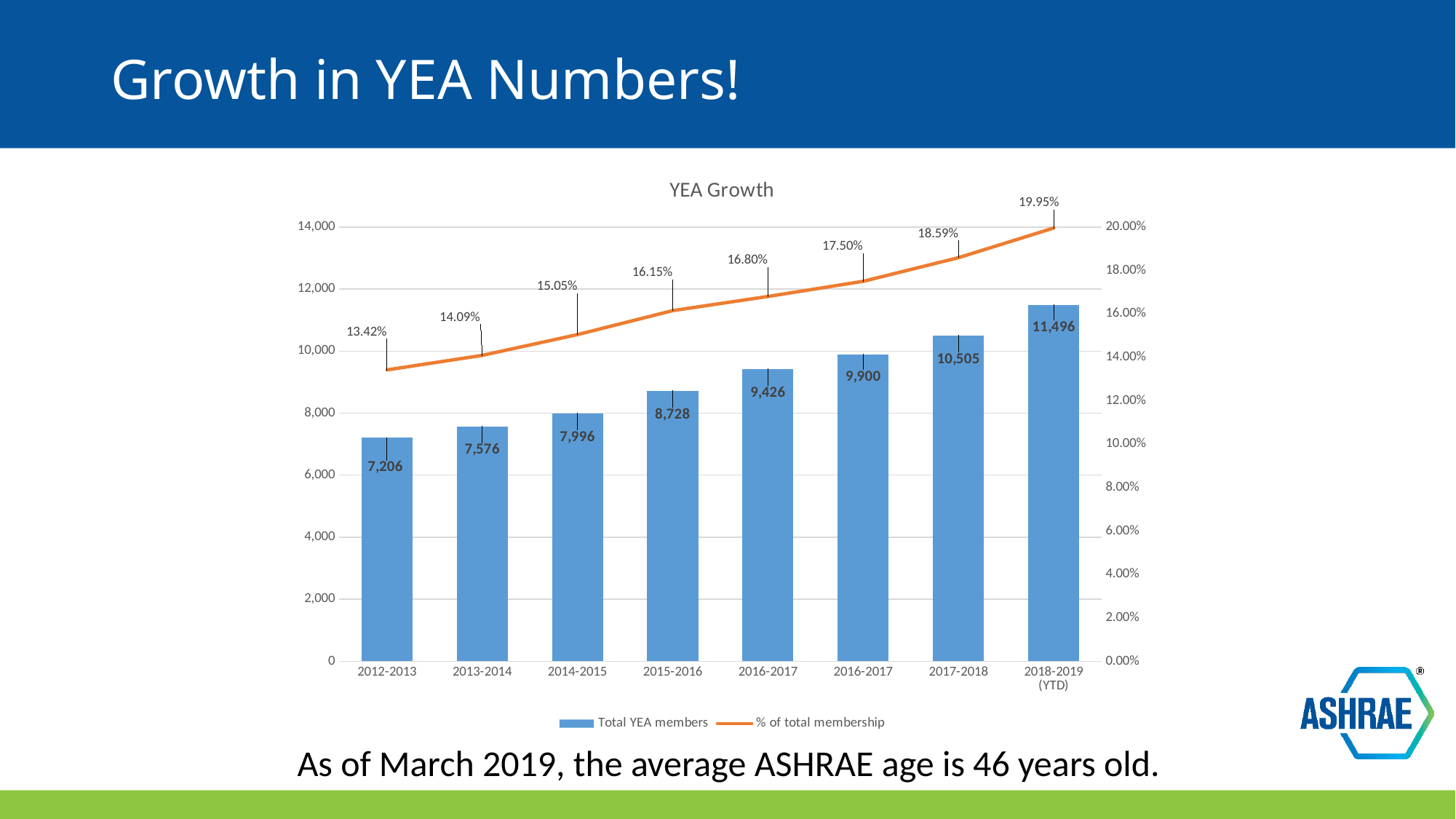
What is the % of total membership for 2014-2015? 15.05% How many series does the legend list? 2 How many bars are plotted in the chart? 8 What is the Total YEA members value for 2015-2016? 8,728 Which category has the lowest % of total membership? 2012-2013 What is the Total YEA members value for 2012-2013? 7,206 Which category has the highest Total YEA members value? 2018-2019 (YTD) What is the difference in Total YEA members between 2017-2018 and 2013-2014? 2,929 What is the % of total membership for 2017-2018? 18.59% What is the Total YEA members value for 2018-2019 (YTD)? 11,496 Does the % of total membership rise or fall across the years along the x axis? rise What is the chart title? YEA Growth